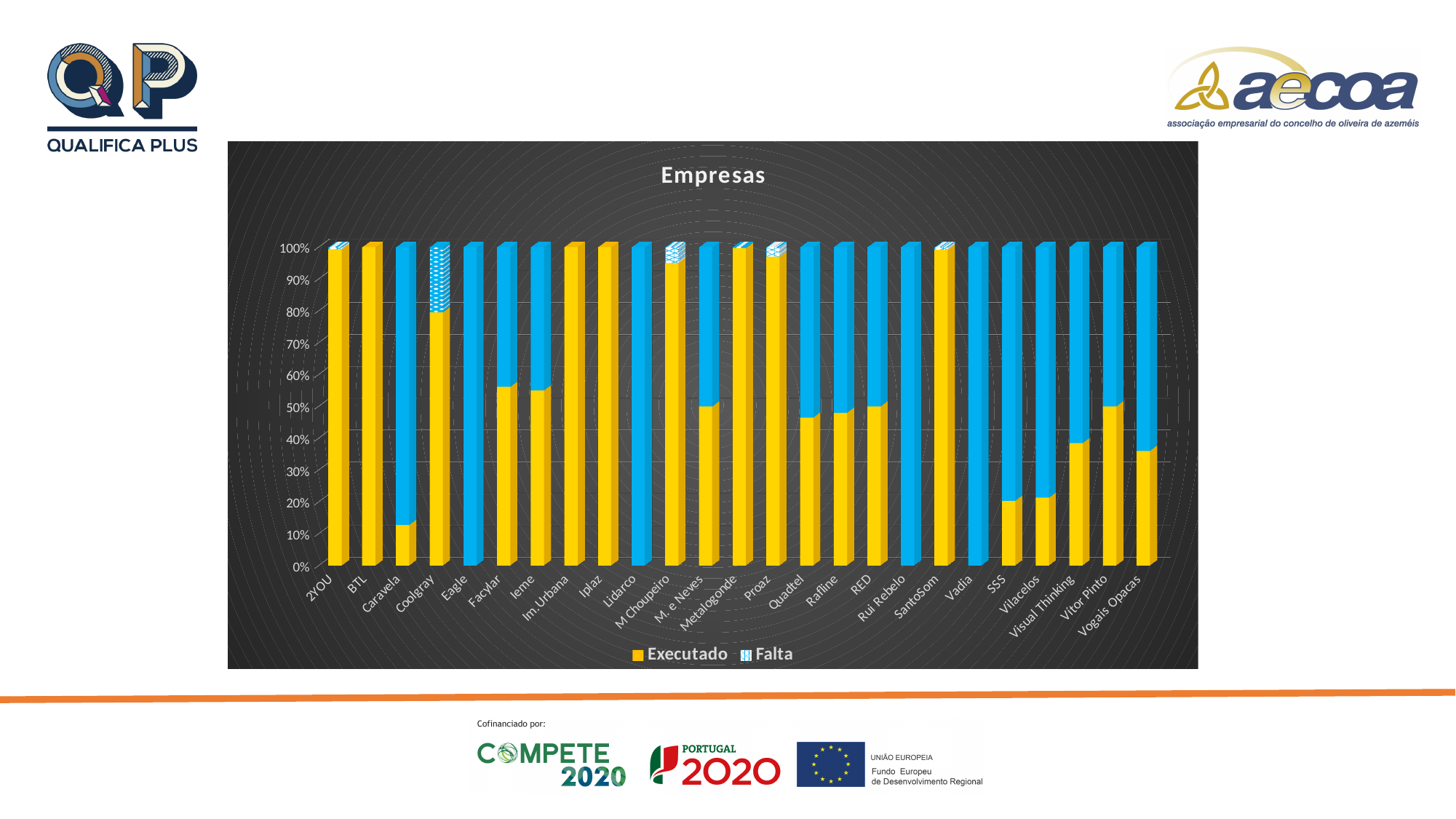
Is the Executado value for Visual Thinking greater or less than 50%? less Is the Executado value for Coolgray greater or less than 70%? greater How many series does the chart's legend list? 2 How many companies (categories) are shown on the x axis? 25 Is the Executado value for Caravela greater or less than 20%? less What is the title of the chart? Empresas Which has a larger Executado share, Vogais Opacas or Vilacelos? Vogais Opacas What kind of chart is shown on the slide? Stacked bar chart Which has a larger Executado share, Coolgray or Caravela? Coolgray What are the two series named in the legend? Executado and Falta